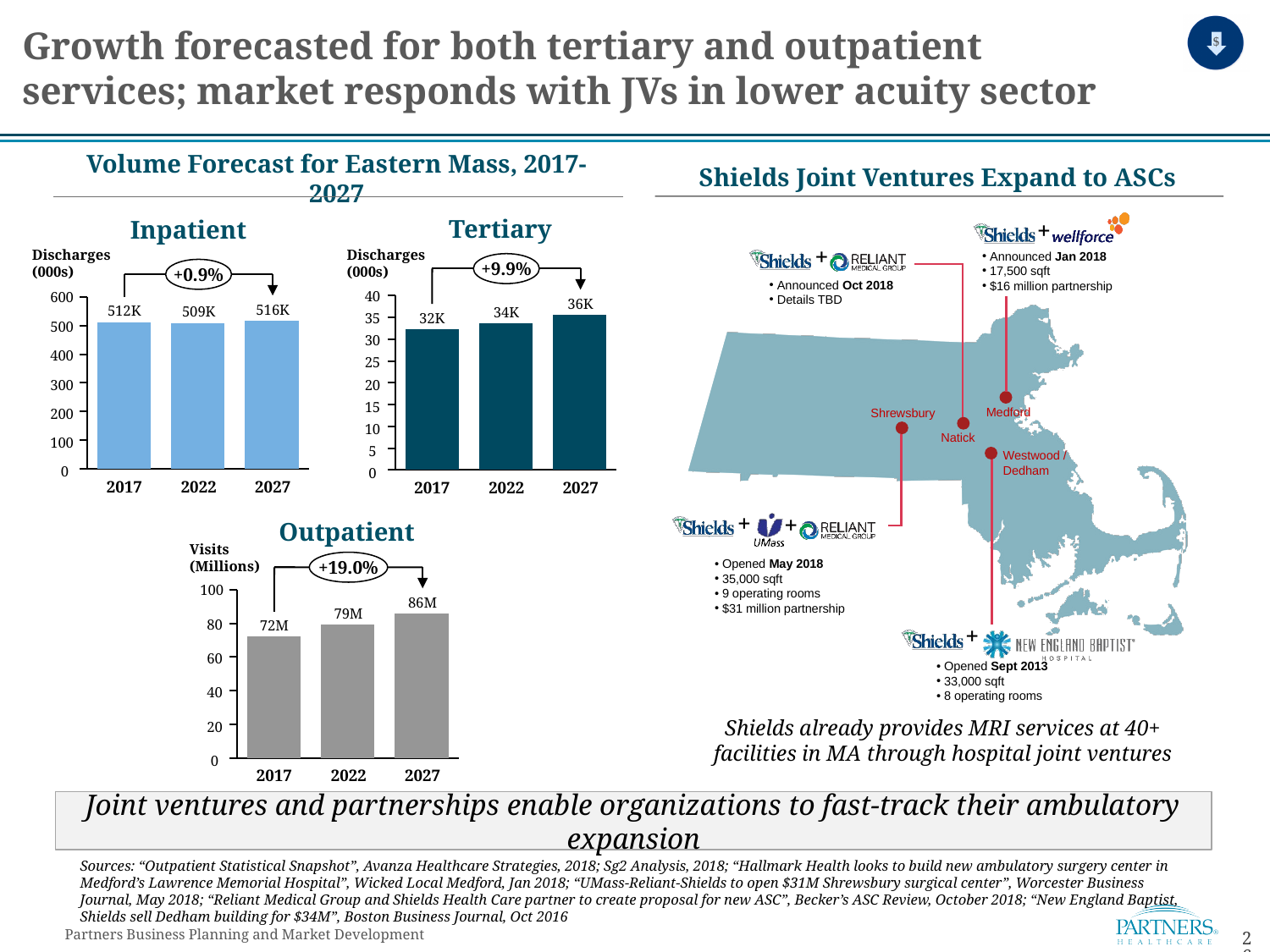
In the Outpatient chart, which year has the highest visits value? 2027 In the Tertiary chart, what is the difference between the 2027 and 2017 discharges values? 4K In the Inpatient chart, which year has the lowest discharges value? 2022 In the Inpatient chart, what is the discharges value for 2027? 516K What growth percentage is shown above the Outpatient chart from 2017 to 2027? +19.0% In the Outpatient chart, what is the visits value for 2022? 79M How many years are plotted in the Outpatient chart? 3 In the Inpatient chart, which is larger, the value for 2017 or the value for 2022? 2017 In the Tertiary chart, is the value for 2022 greater or less than 30? greater What kind of chart is the Tertiary chart? Bar chart In the Outpatient chart, what is the difference between the 2027 and 2017 visits values? 14M In the Tertiary chart, what is the discharges value for 2017? 32K